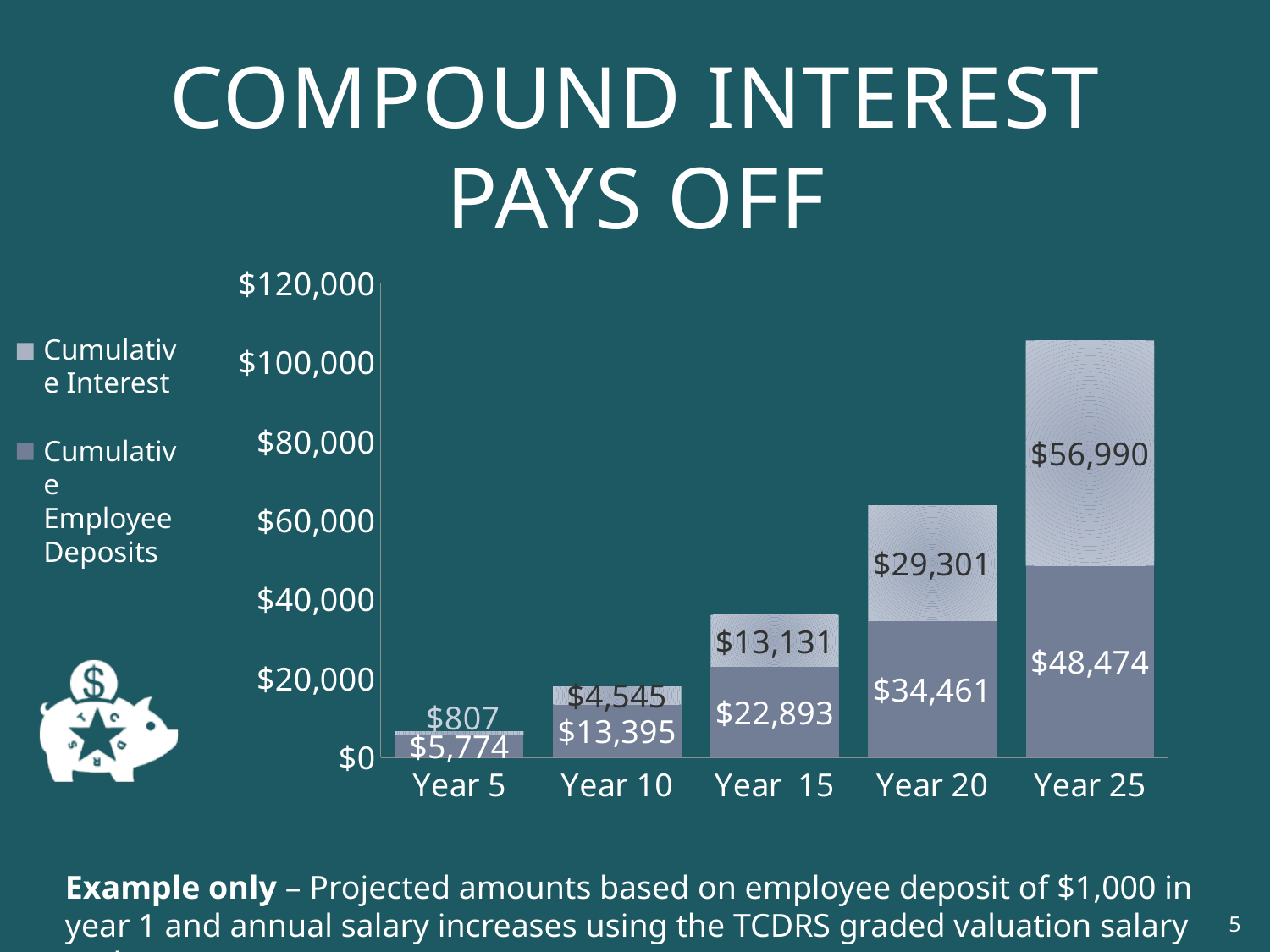
What is the Cumulative Employee Deposits value for Year 25? $48,474 Is the total stacked bar for Year 25 greater or less than $100,000? greater How many series does the legend list? 2 What is the Cumulative Interest value for Year 15? $13,131 How many years are shown on the x axis? 5 What is the Cumulative Interest value for Year 5? $807 Which year has the highest Cumulative Interest? Year 25 In Year 20, which is larger: Cumulative Employee Deposits or Cumulative Interest? Cumulative Employee Deposits What kind of chart is shown on the slide? Stacked bar chart What is the difference between Cumulative Interest and Cumulative Employee Deposits in Year 25? $8,516 What is the total of the stacked bar for Year 10? $17,940 Which year has the lowest Cumulative Employee Deposits? Year 5